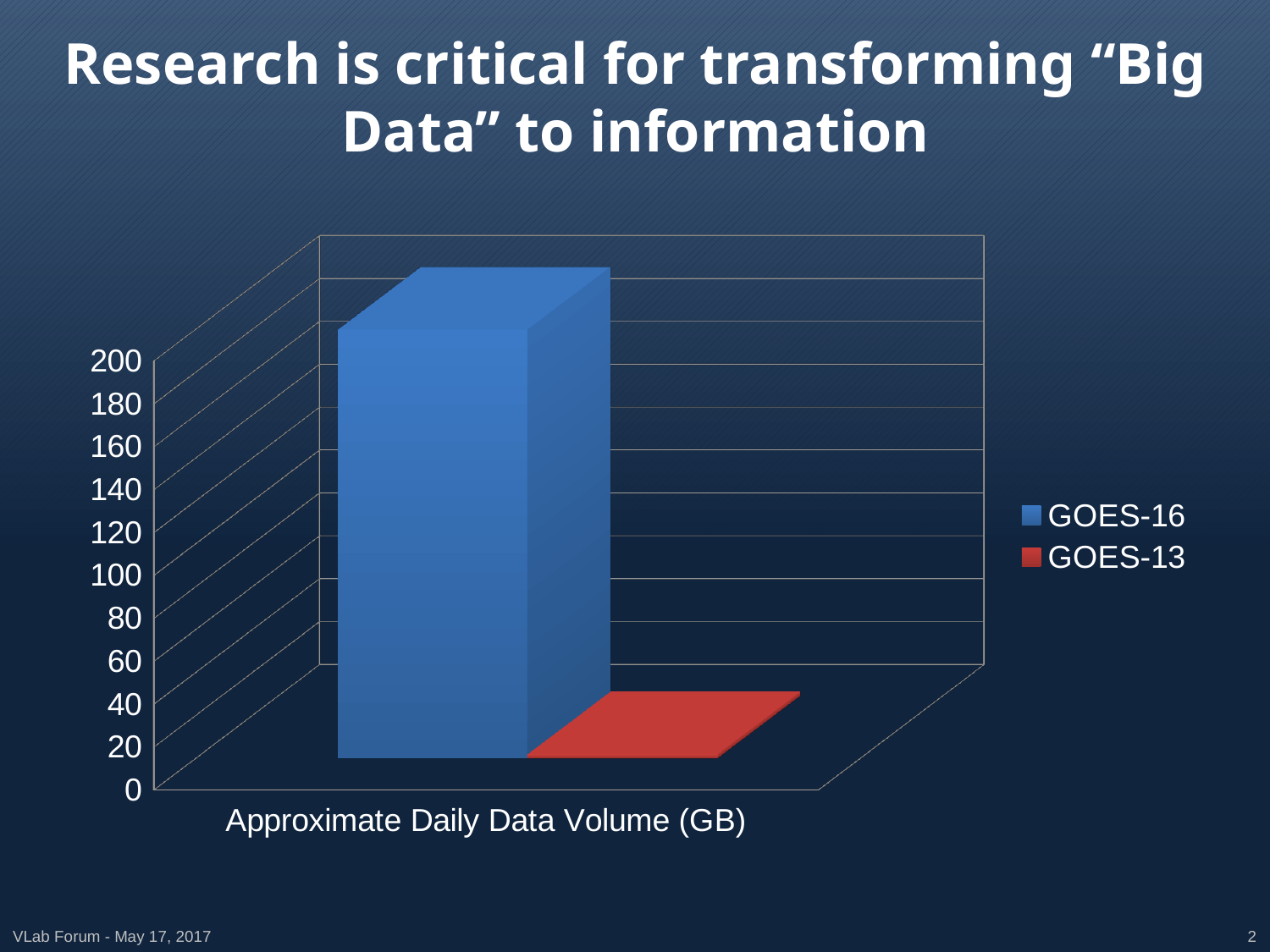
Is the value for GOES-13 greater or less than 40? less Which is larger, the daily data volume for GOES-16 or for GOES-13? GOES-16 Which series has the lower approximate daily data volume? GOES-13 Is the value for GOES-16 greater or less than 100? greater Is the value for GOES-16 greater or less than 140? greater How many categories are shown on the x axis? 1 Which series has the higher approximate daily data volume? GOES-16 How many series does the legend list? 2 What is the label on the x axis of the chart? Approximate Daily Data Volume (GB) What kind of chart is shown on the slide? bar chart What colour is the GOES-13 series in the chart? red